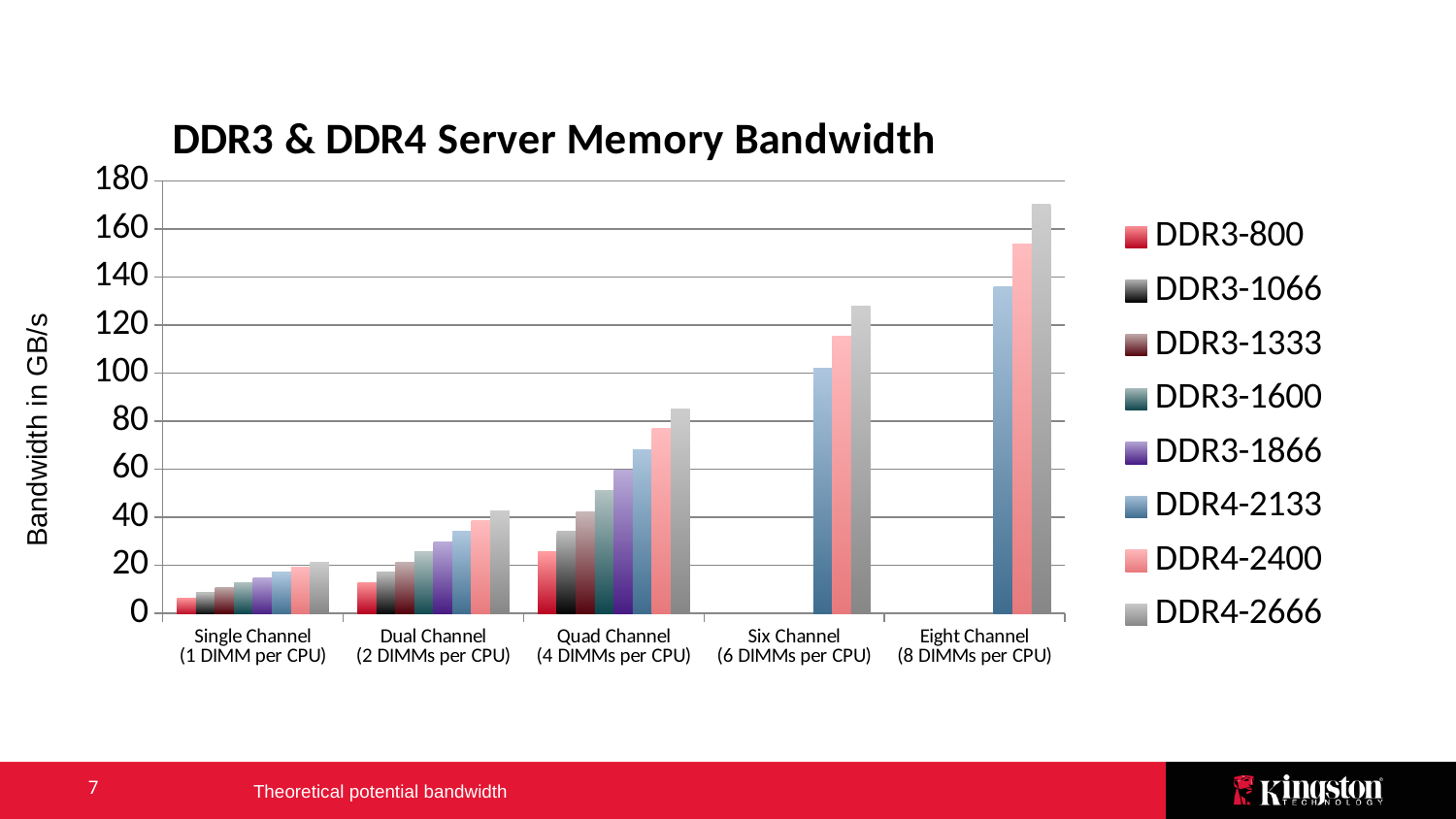
Which is larger: DDR4-2666 in the Quad Channel category or DDR4-2133 in the Six Channel category? DDR4-2133 in the Six Channel category Do the bandwidth values for DDR4-2666 rise or fall as the number of channels increases along the x axis? rise How many channel configurations (categories) are shown on the x axis? 5 What is the label on the vertical axis of the chart? Bandwidth in GB/s Is the value for DDR3-800 in the Dual Channel category greater or less than 20? less Is the value for DDR4-2400 in the Six Channel category greater or less than 100? greater Is the value for DDR4-2666 in the Six Channel category greater or less than 120? greater Which memory type has the lowest bandwidth in the Single Channel category? DDR3-800 How many memory types does the legend list? 8 Which memory type and channel configuration has the highest bandwidth on the chart? DDR4-2666, Eight Channel What kind of chart is shown on the slide? bar chart